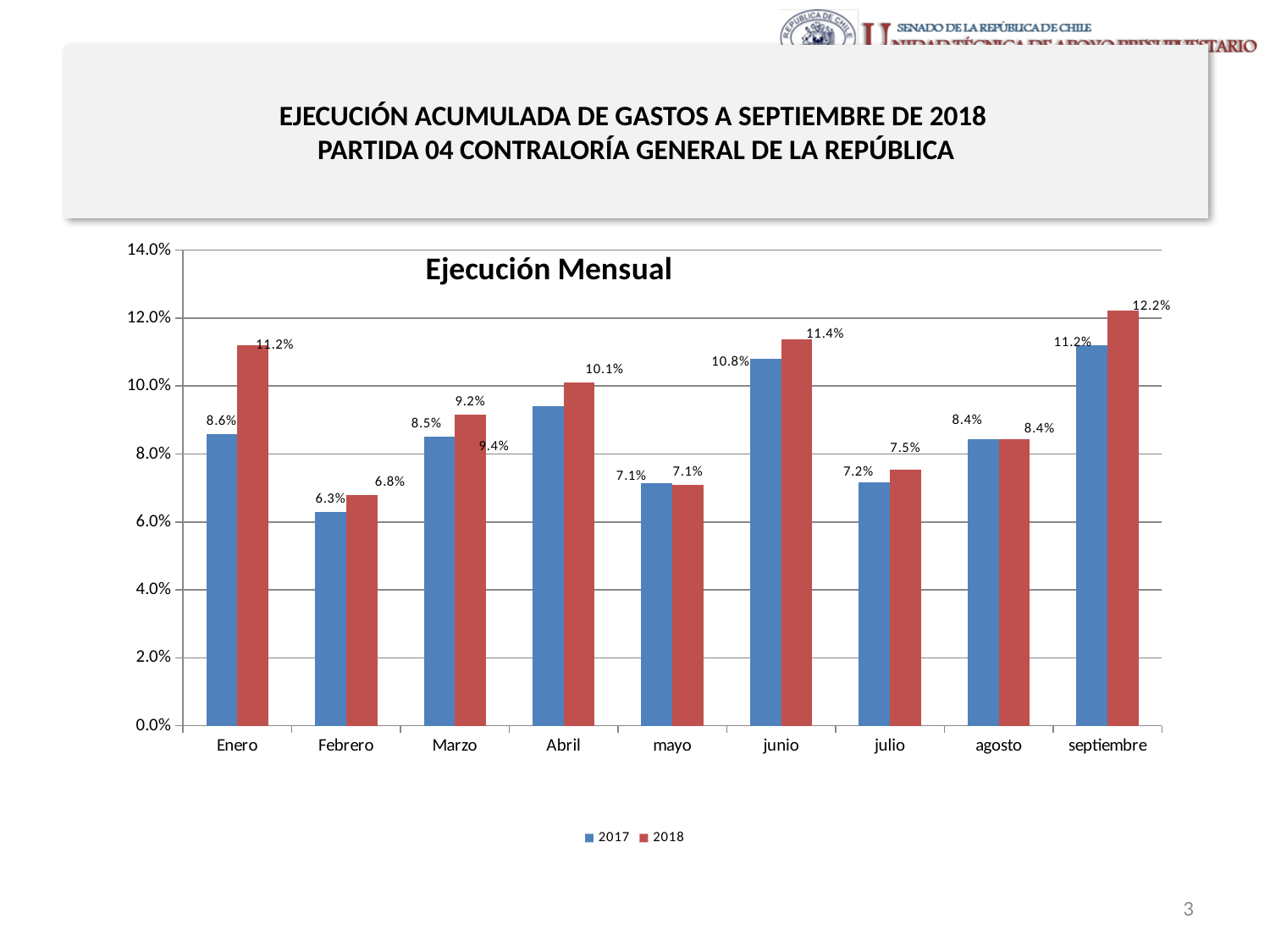
What is the title of the chart? Ejecución Mensual What is the value for 2018 in Enero? 11.2% Is the value for 2018 in Abril greater or less than 10.0%? greater What is the value for 2017 in septiembre? 11.2% How many series does the legend list? 2 What is the value for 2018 in junio? 11.4% What is the difference between the 2018 and 2017 values in Enero? 2.6% What is the value for 2017 in Febrero? 6.3% Which month has the lowest value for the 2017 series? Febrero How many months are shown on the x axis? 9 Which month has the highest value for the 2018 series? septiembre Which is larger in julio, the 2017 value or the 2018 value? 2018